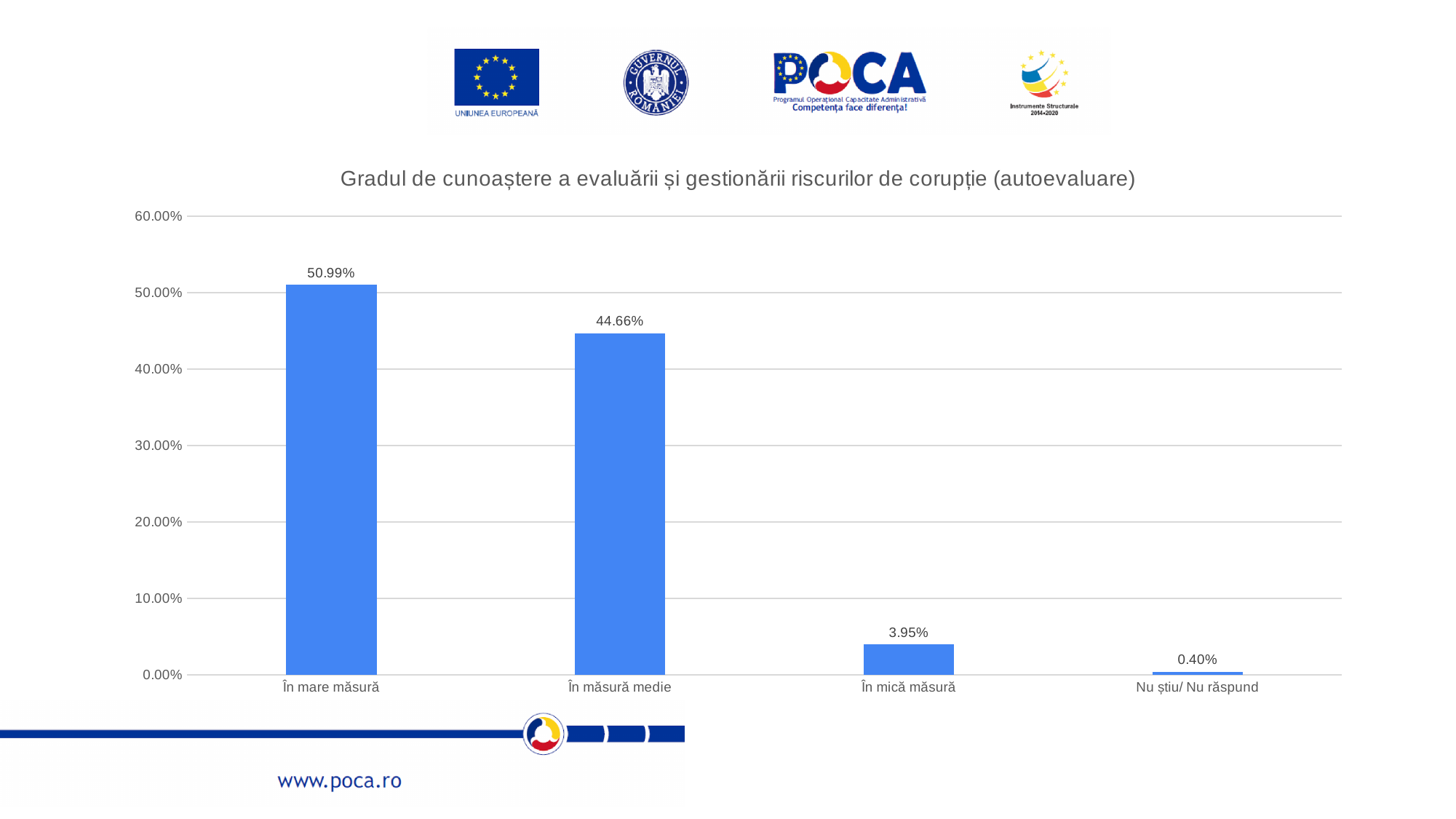
Which category has the highest value? În mare măsură How many categories are shown on the x axis? 4 What is the value for În măsură medie? 44.66% What is the difference between the values for În mare măsură and În măsură medie? 6.33% What is the title of the chart? Gradul de cunoaștere a evaluării și gestionării riscurilor de corupție (autoevaluare) What kind of chart is shown on the slide? bar chart What is the value for În mică măsură? 3.95% Which is larger, the value for În mică măsură or the value for Nu știu/ Nu răspund? În mică măsură Which category has the lowest value? Nu știu/ Nu răspund Is the value for În măsură medie greater or less than 40.00%? greater What is the value for Nu știu/ Nu răspund? 0.40% What is the value for În mare măsură? 50.99%